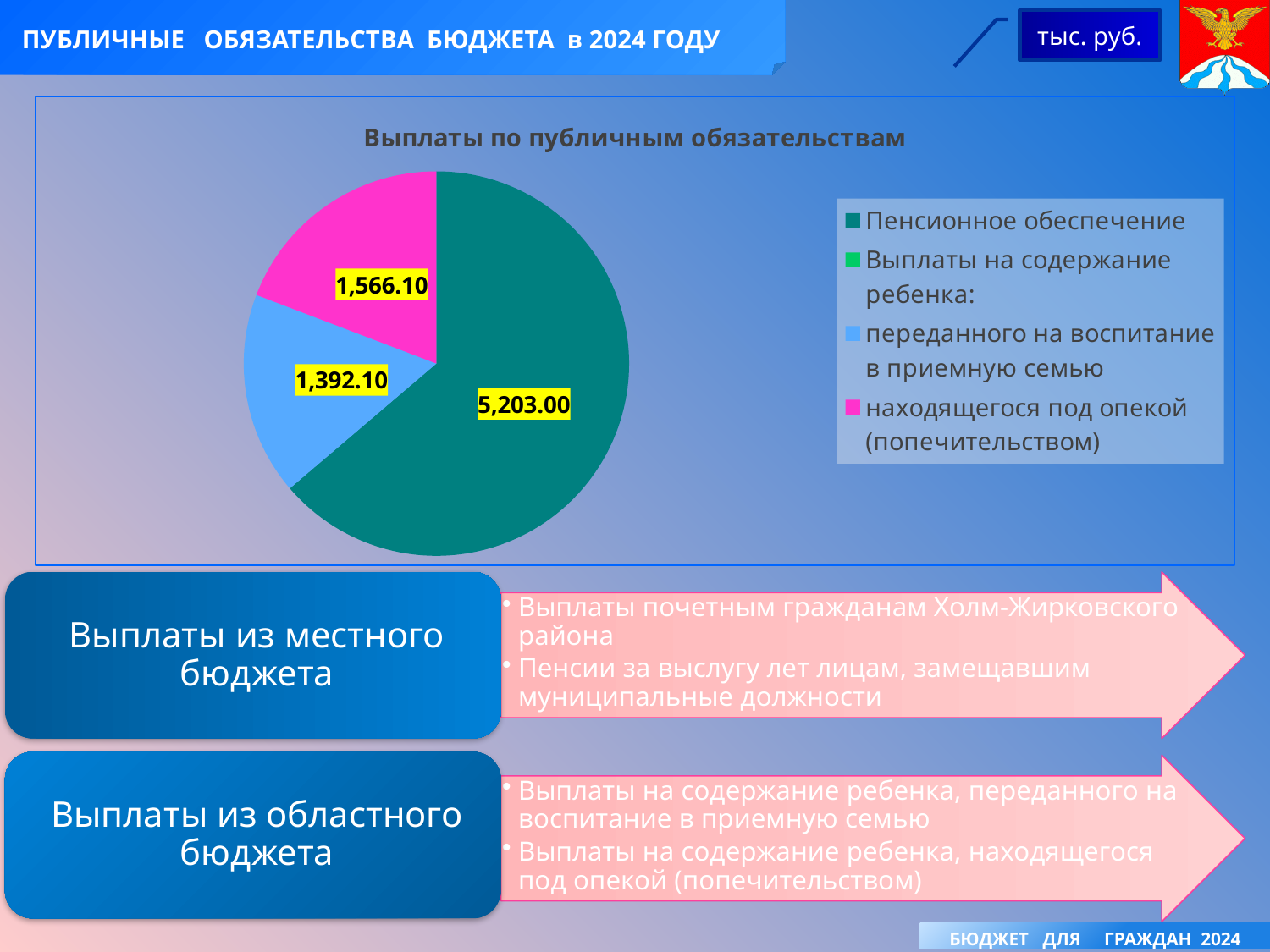
What is the value for the slice 'находящегося под опекой (попечительством)'? 1,566.10 What is the title of the chart? Выплаты по публичным обязательствам Which is larger: the value for 'находящегося под опекой (попечительством)' or the value for 'переданного на воспитание в приемную семью'? находящегося под опекой (попечительством) What is the value for the slice 'переданного на воспитание в приемную семью'? 1,392.10 What type of chart is shown on the slide? Pie chart What is the value for Пенсионное обеспечение? 5,203.00 What is the difference between the value for 'находящегося под опекой (попечительством)' and the value for 'переданного на воспитание в приемную семью'? 174.00 What unit of measurement is indicated for the values on the slide? тыс. руб. Which category has the smallest slice of the pie? переданного на воспитание в приемную семью How many slices with data labels are shown in the pie chart? 3 What is the difference between the value for Пенсионное обеспечение and the value for 'переданного на воспитание в приемную семью'? 3,810.90 Which category has the largest slice of the pie? Пенсионное обеспечение